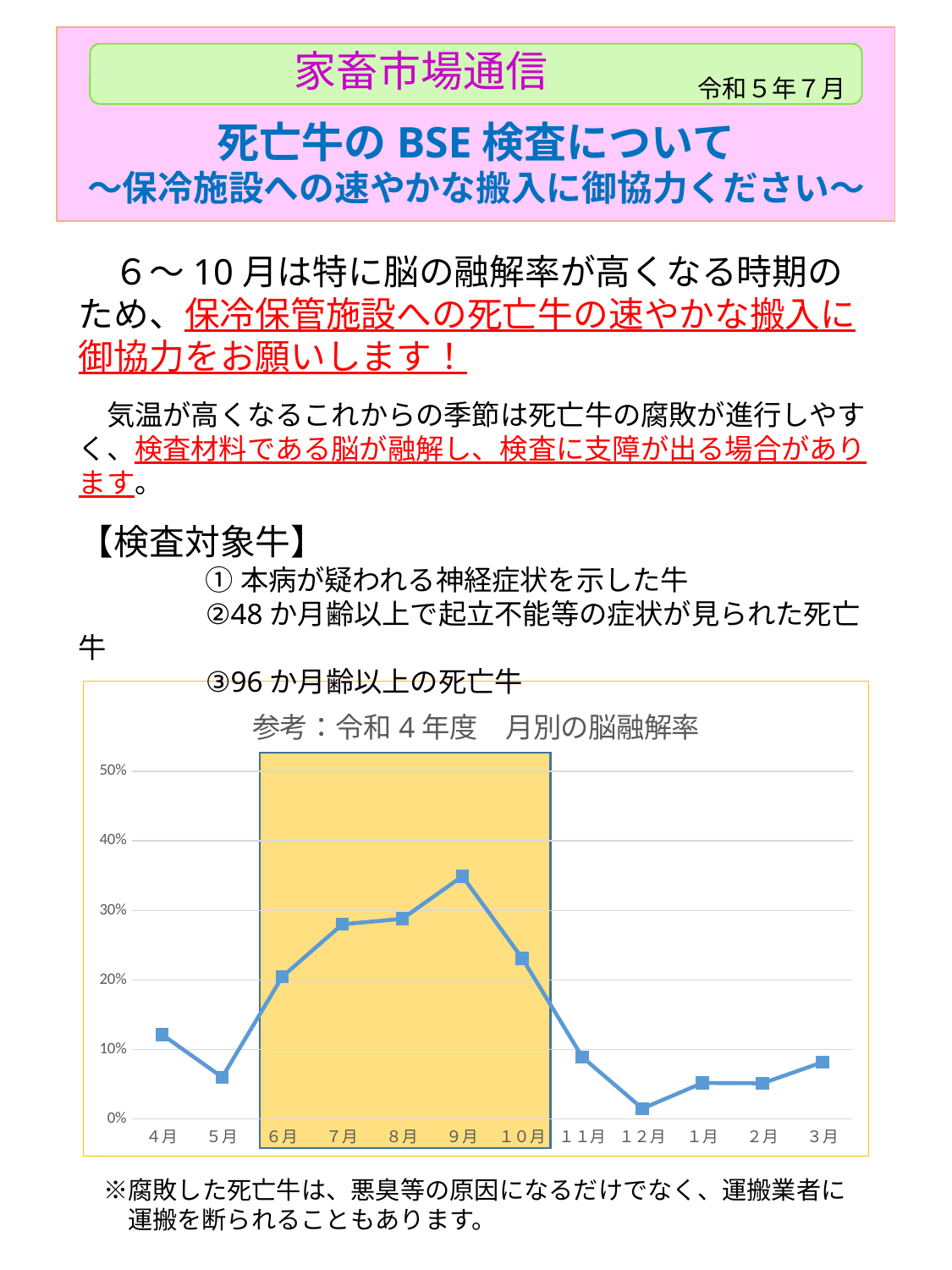
Is the value for 5月 greater or less than 10%? less How many months are plotted on the x axis of the chart? 12 Is the value for 9月 greater or less than 30%? greater Is the value for 7月 greater or less than 20%? greater Which month has a higher value, 9月 or 4月? 9月 Which month has a higher value, 6月 or 12月? 6月 What kind of chart is shown on the slide? line chart What is the title of the chart? 参考：令和4年度 月別の脳融解率 Do the values rise or fall from 5月 to 9月? rise Which month has the lowest brain melting rate in the chart? 12月 Which month has the highest brain melting rate in the chart? 9月